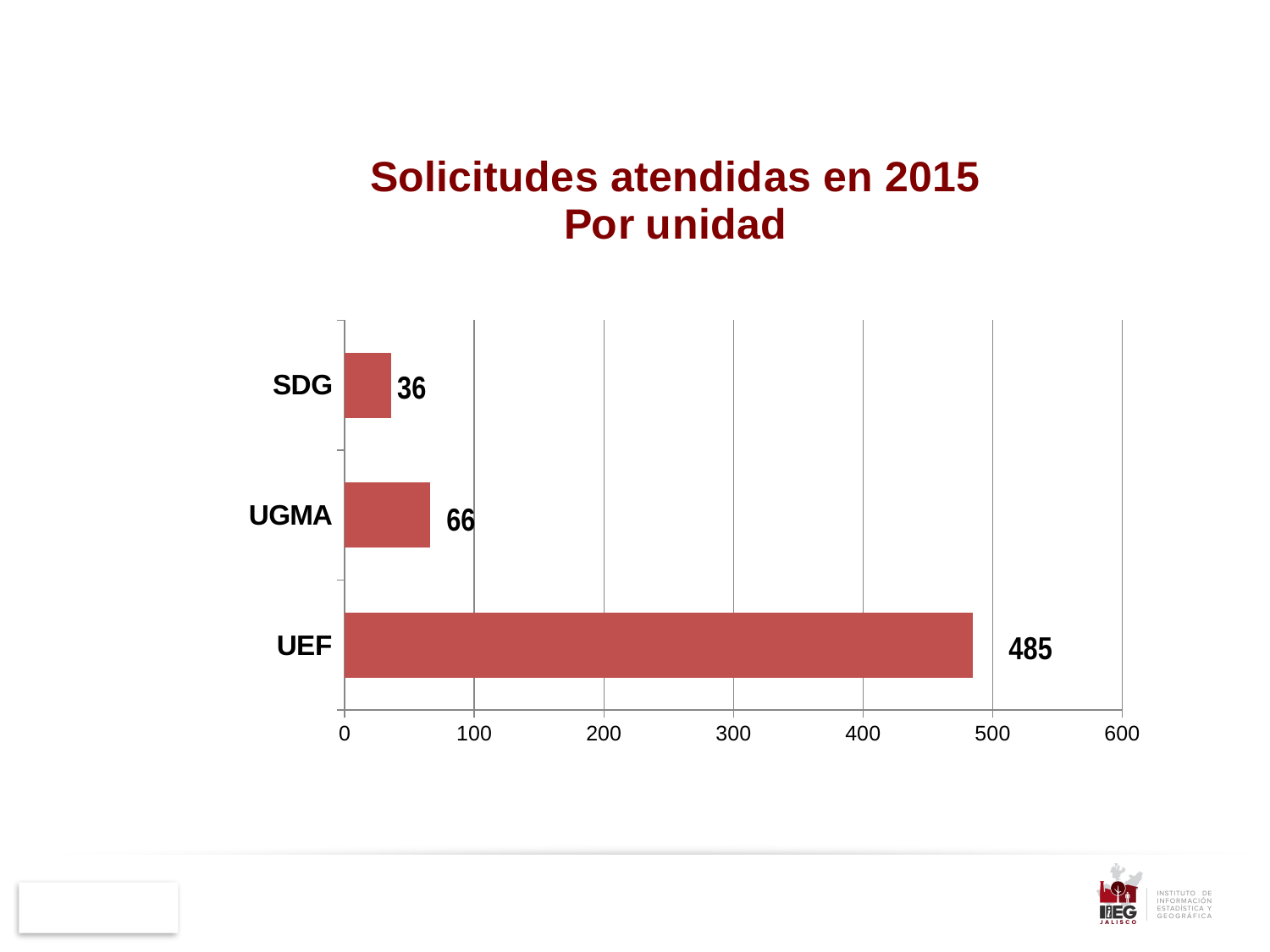
What is the difference between the values for UGMA and SDG? 30 Which unit has the highest number of solicitudes atendidas? UEF What is the value for SDG? 36 What is the title of the chart? Solicitudes atendidas en 2015 Por unidad How many units are shown in the chart? 3 What is the value for UGMA? 66 What is the difference between the values for UEF and UGMA? 419 Which is larger, the value for UGMA or the value for SDG? UGMA Which unit has the lowest number of solicitudes atendidas? SDG What is the value for UEF? 485 What kind of chart is shown on the slide? bar chart Is the value for UEF greater or less than 400? greater